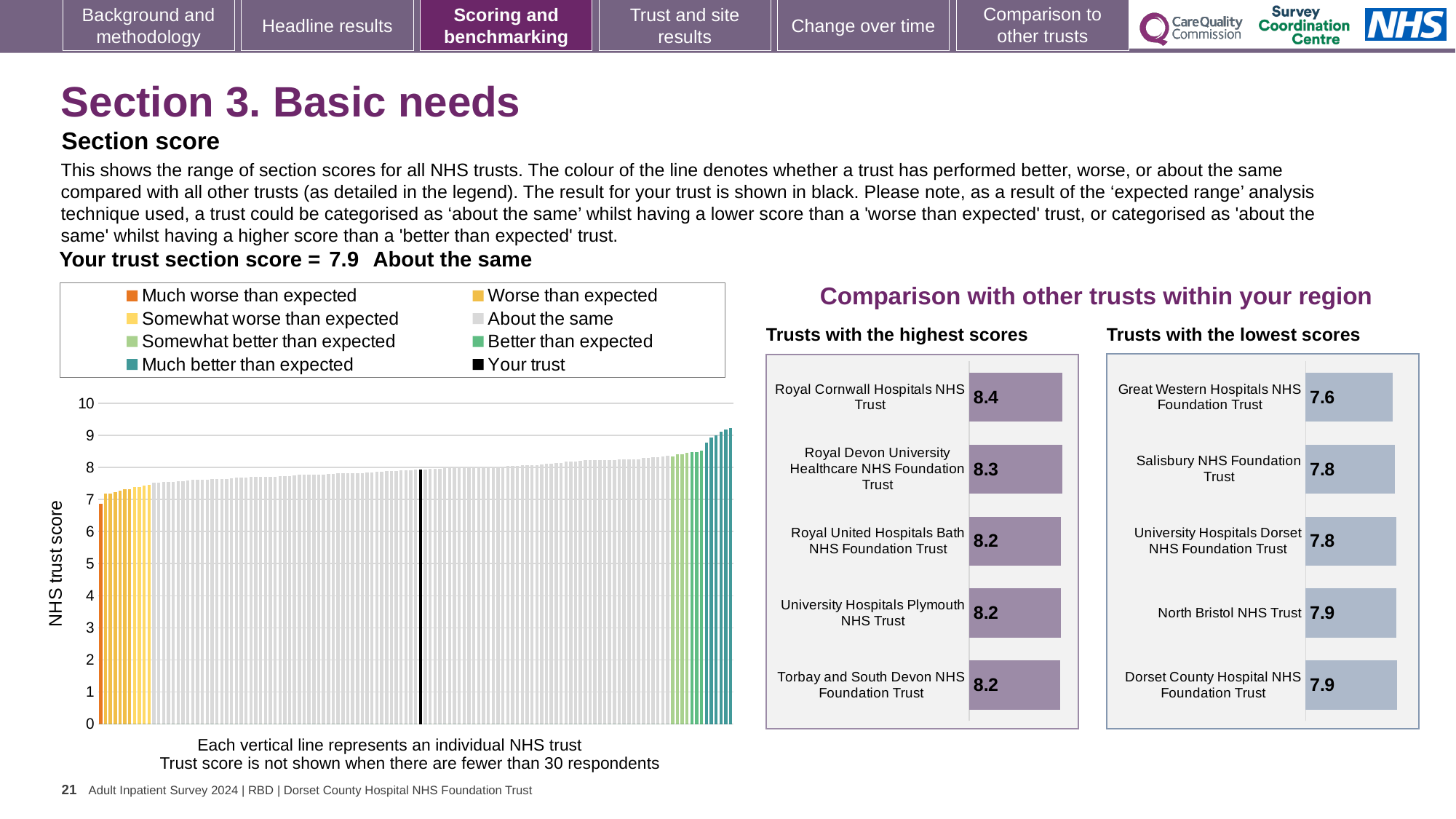
What is the section score for your trust shown on the slide? 7.9 In the large chart on the left, what is the label on the vertical axis? NHS trust score In the 'Trusts with the lowest scores' chart, which trust has the lowest score? Great Western Hospitals NHS Foundation Trust In the 'Trusts with the highest scores' chart, what is the difference between the scores of Royal Cornwall Hospitals NHS Trust and Torbay and South Devon NHS Foundation Trust? 0.2 How many entries does the legend above the large chart on the left list? 8 In the 'Trusts with the highest scores' chart, how many trusts are shown? 5 In the large chart on the left, do the bar heights rise or fall from left to right? rise Which is larger: the score for Royal Devon University Healthcare NHS Foundation Trust in the 'Trusts with the highest scores' chart or the score for Salisbury NHS Foundation Trust in the 'Trusts with the lowest scores' chart? Royal Devon University Healthcare NHS Foundation Trust In the 'Trusts with the highest scores' chart, which trust has the highest score? Royal Cornwall Hospitals NHS Trust In the 'Trusts with the highest scores' chart, what is the score for Royal Cornwall Hospitals NHS Trust? 8.4 In the 'Trusts with the lowest scores' chart, what is the score for Great Western Hospitals NHS Foundation Trust? 7.6 What kind of chart is the large chart on the left showing NHS trust scores? bar chart